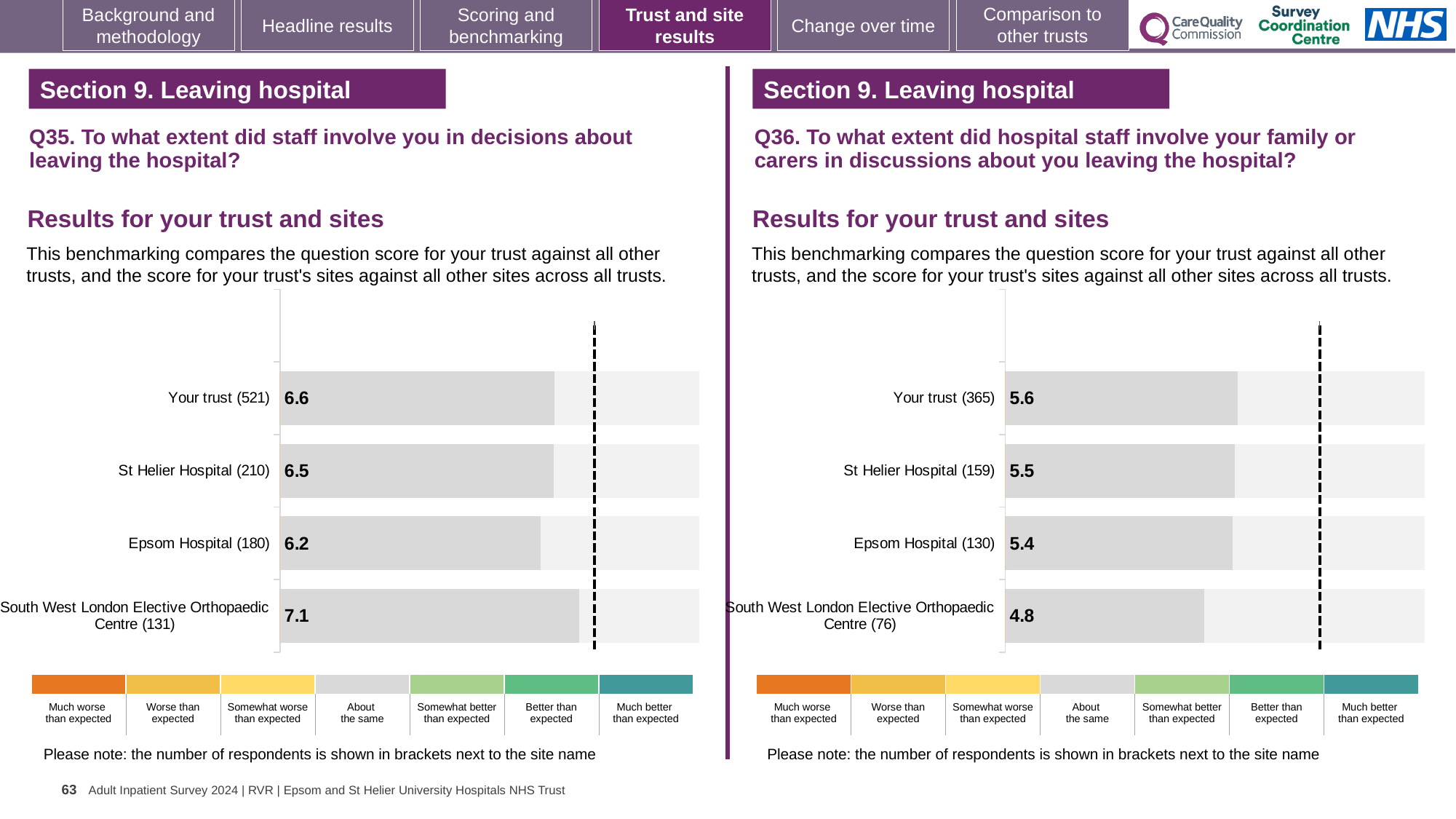
In the Q36 chart on the right, what is the score for South West London Elective Orthopaedic Centre? 4.8 In the Q35 chart on the left, what is the score for Your trust? 6.6 In the Q36 chart on the right, what is the difference between the scores for Your trust and South West London Elective Orthopaedic Centre? 0.8 How many bars are plotted in the Q35 chart on the left? 4 In the Q35 chart on the left, which site has the highest score? South West London Elective Orthopaedic Centre In the Q36 chart on the right, which site has the lowest score? South West London Elective Orthopaedic Centre In the Q35 chart on the left, what is the difference between the scores for South West London Elective Orthopaedic Centre and Epsom Hospital? 0.9 In the Q36 chart on the right, what is the score for St Helier Hospital? 5.5 In the Q35 chart on the left, which site has the lowest score? Epsom Hospital In the Q36 chart on the right, which is larger, the score for Your trust or the score for Epsom Hospital? Your trust What kind of chart is used for the Q36 results on the right? Bar chart In the Q35 chart on the left, what is the score for Epsom Hospital? 6.2